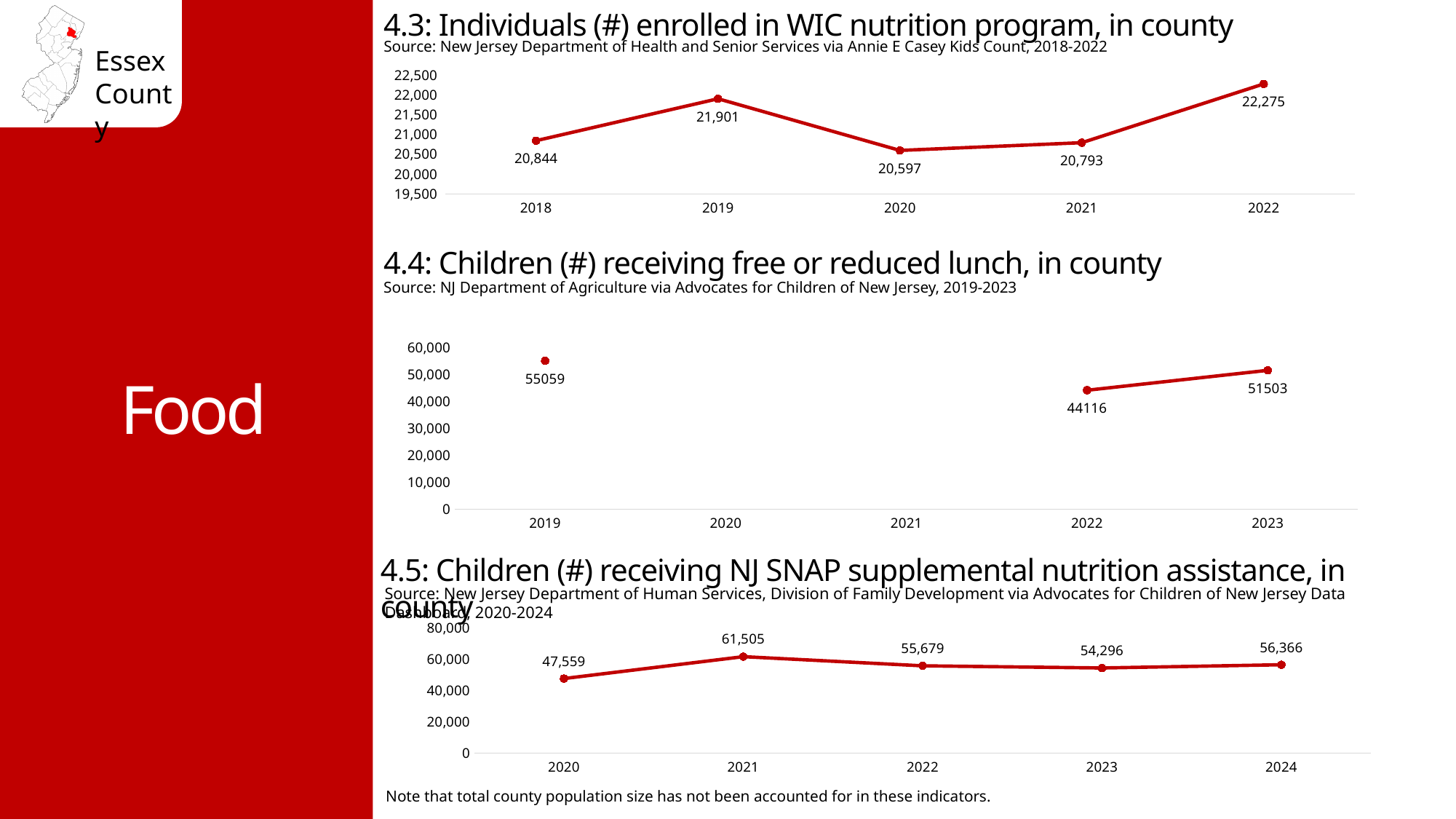
In chart 4.3 (Individuals enrolled in WIC nutrition program), what is the difference between the 2022 and 2018 values? 1,431 In chart 4.3 (Individuals enrolled in WIC nutrition program), what is the value for 2022? 22,275 In chart 4.5 (Children receiving NJ SNAP), is the value for 2024 larger or smaller than the value for 2023? larger In chart 4.5 (Children receiving NJ SNAP), what is the value for 2021? 61,505 In chart 4.5 (Children receiving NJ SNAP), which year has the highest value? 2021 In chart 4.3 (Individuals enrolled in WIC nutrition program), how many years are plotted on the x axis? 5 In chart 4.3 (Individuals enrolled in WIC nutrition program), which year has the lowest value? 2020 What type of chart is chart 4.5 (Children receiving NJ SNAP)? line chart In chart 4.4 (Children receiving free or reduced lunch), how many data points are plotted? 3 In chart 4.4 (Children receiving free or reduced lunch), what is the value for 2019? 55059 In chart 4.4 (Children receiving free or reduced lunch), what is the difference between the 2023 and 2022 values? 7387 In chart 4.4 (Children receiving free or reduced lunch), which year has the lowest value? 2022